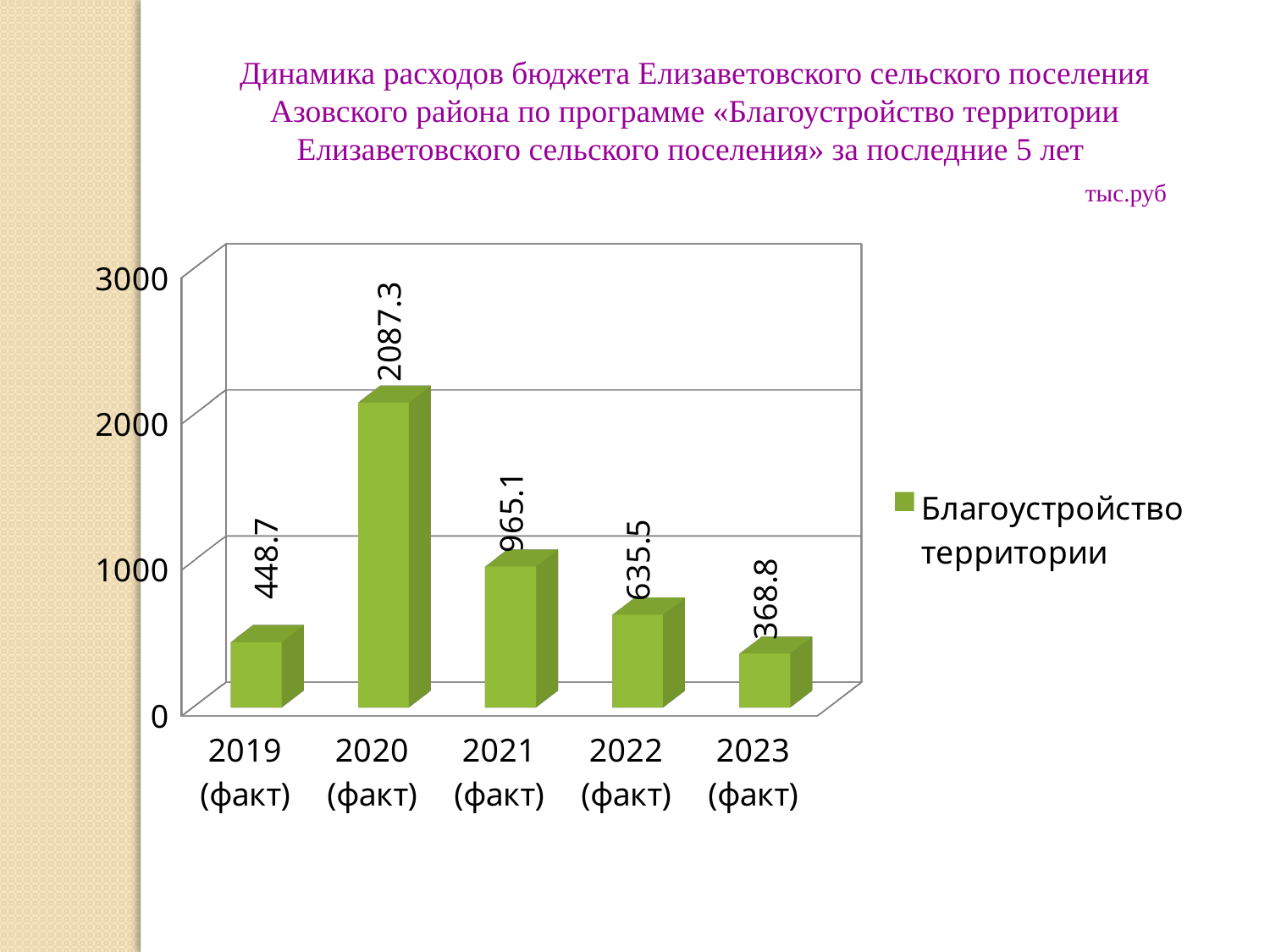
What is the value for 2020 (факт)? 2087.3 Is the value for 2021 (факт) greater or less than 1000? less Which year has the lowest value? 2023 (факт) Which year has the highest value? 2020 (факт) What is the difference between the values for 2019 (факт) and 2023 (факт)? 79.9 What series name does the legend list? Благоустройство территории What kind of chart is shown on the slide? bar chart What is the difference between the values for 2020 (факт) and 2021 (факт)? 1122.2 What is the value for 2021 (факт)? 965.1 Which is larger, the value for 2019 (факт) or the value for 2022 (факт)? 2022 (факт) How many years are shown on the x axis? 5 What is the value for 2023 (факт)? 368.8